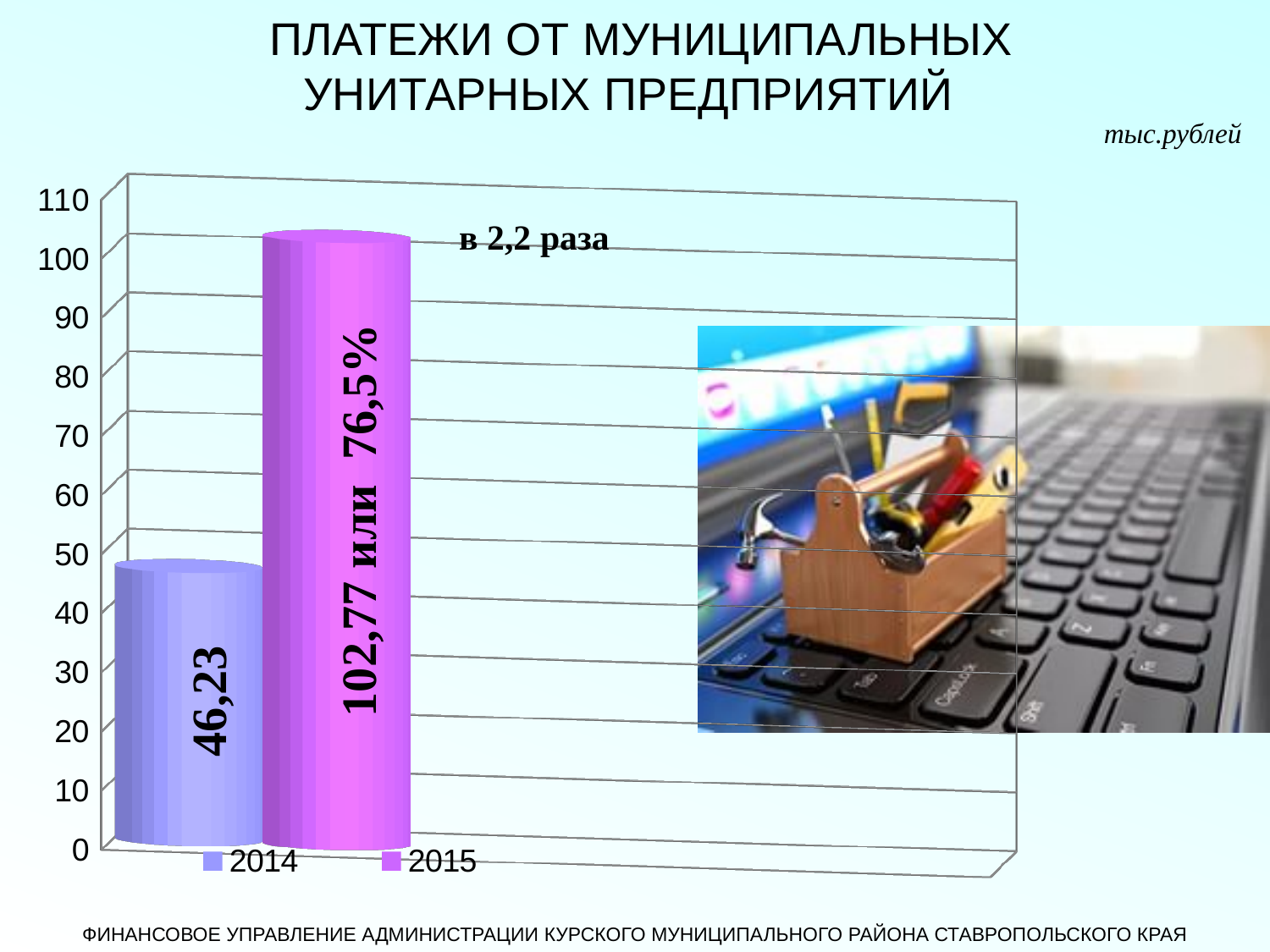
Which year has the higher value? 2015 What is the value for 2015? 102,77 Is the value for 2015 greater or less than 100? greater Is the value for 2014 greater or less than 50? less How many entries does the legend list? 2 What is the value for 2014? 46,23 How many bars are plotted on the chart? 2 Do the values rise or fall from 2014 to 2015? rise What unit of measurement is stated for the chart? тыс.рублей What is the difference between the 2015 and 2014 values? 56,54 What kind of chart is shown on the slide? bar chart Which year has the lower value? 2014